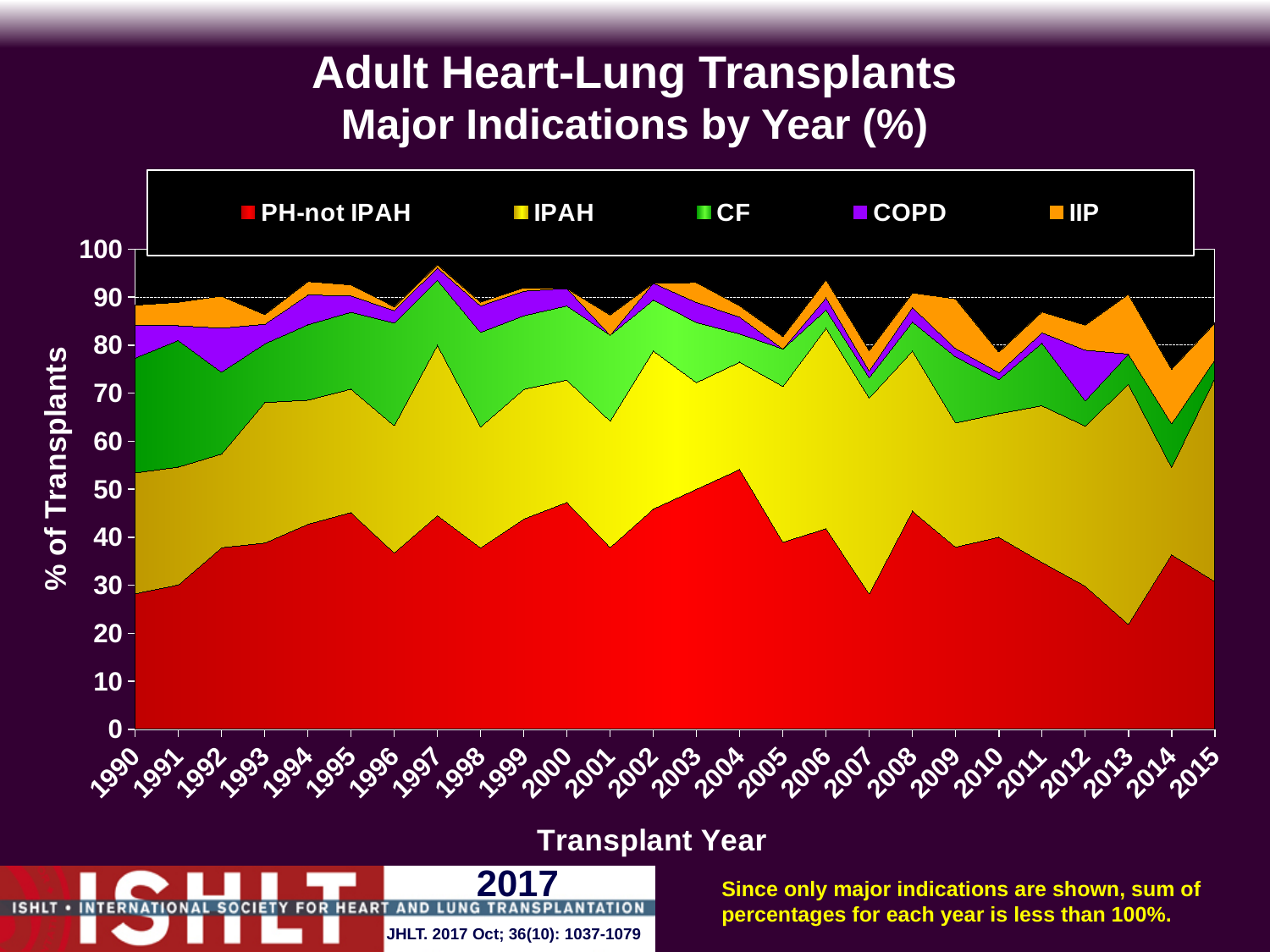
How many series does the legend list? 5 Which year has the larger PH-not IPAH share, 2004 or 2013? 2004 Is the total of all stacked indications in 1997 greater or less than 90? greater What kind of chart is shown on the slide? Stacked area chart What is the label of the y axis? % of Transplants In which year is the PH-not IPAH share the lowest? 2013 Is the total of all stacked indications in 2014 greater or less than 80? less In which year is the PH-not IPAH share the highest? 2004 Is the value for PH-not IPAH in 2013 greater or less than 30? less How many transplant years are plotted along the x axis? 26 Which indication is shown in red at the bottom of the stack? PH-not IPAH